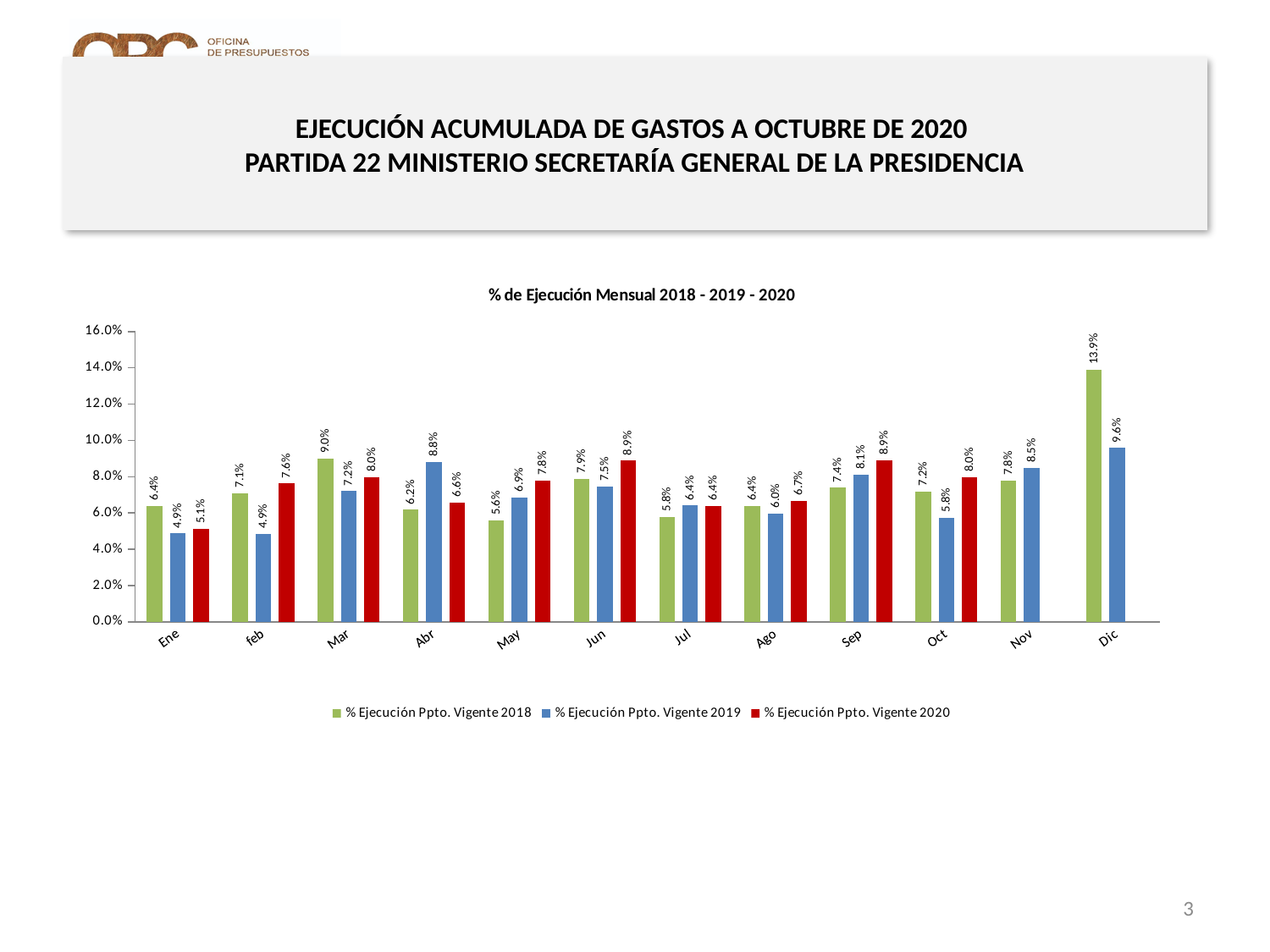
Is the value for Dic in the 2018 series greater or less than 12.0%? greater What kind of chart is shown on the slide? Bar chart What is the value of % Ejecución Ppto. Vigente 2018 for May? 5.6% How many series does the legend list? 3 What colour represents % Ejecución Ppto. Vigente 2020 in the chart? Red Which month has the highest value for % Ejecución Ppto. Vigente 2018? Dic What is the value of % Ejecución Ppto. Vigente 2019 for Abr? 8.8% What is the value of % Ejecución Ppto. Vigente 2020 for Mar? 8.0% How many months are shown on the x axis? 12 What is the difference between the 2018 and 2019 values for Dic? 4.3% For Abr, which series is larger: % Ejecución Ppto. Vigente 2018 or % Ejecución Ppto. Vigente 2019? % Ejecución Ppto. Vigente 2019 Which month has the lowest value for % Ejecución Ppto. Vigente 2020? Ene